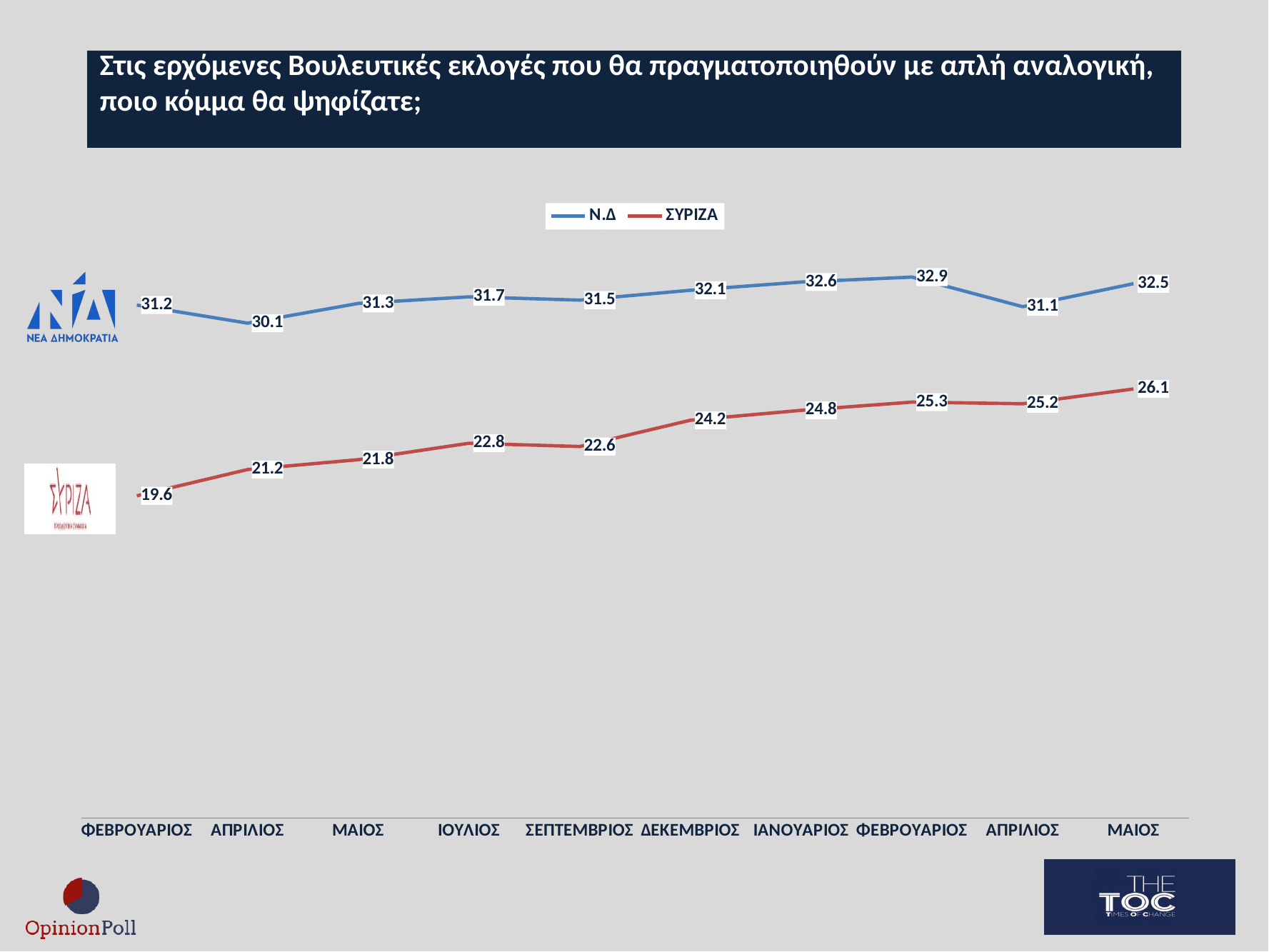
What is the value for ΣΥΡΙΖΑ at ΔΕΚΕΜΒΡΙΟΣ? 24.2 What is the lowest value shown for ΣΥΡΙΖΑ? 19.6 What is the difference between Ν.Δ and ΣΥΡΙΖΑ at ΙΟΥΛΙΟΣ? 8.9 What is the difference between Ν.Δ and ΣΥΡΙΖΑ at ΔΕΚΕΜΒΡΙΟΣ? 7.9 At which x-axis point does Ν.Δ reach its highest value? The second ΦΕΒΡΟΥΑΡΙΟΣ (32.9) What is the value for Ν.Δ at ΙΟΥΛΙΟΣ? 31.7 What is the lowest value shown for Ν.Δ? 30.1 How many series does the legend list? 2 What kind of chart is shown on the slide? Line chart What is the value for ΣΥΡΙΖΑ at the last ΜΑΙΟΣ point on the x axis? 26.1 Which series has the higher value at ΙΑΝΟΥΑΡΙΟΣ, Ν.Δ or ΣΥΡΙΖΑ? Ν.Δ How many data points does each line have? 10